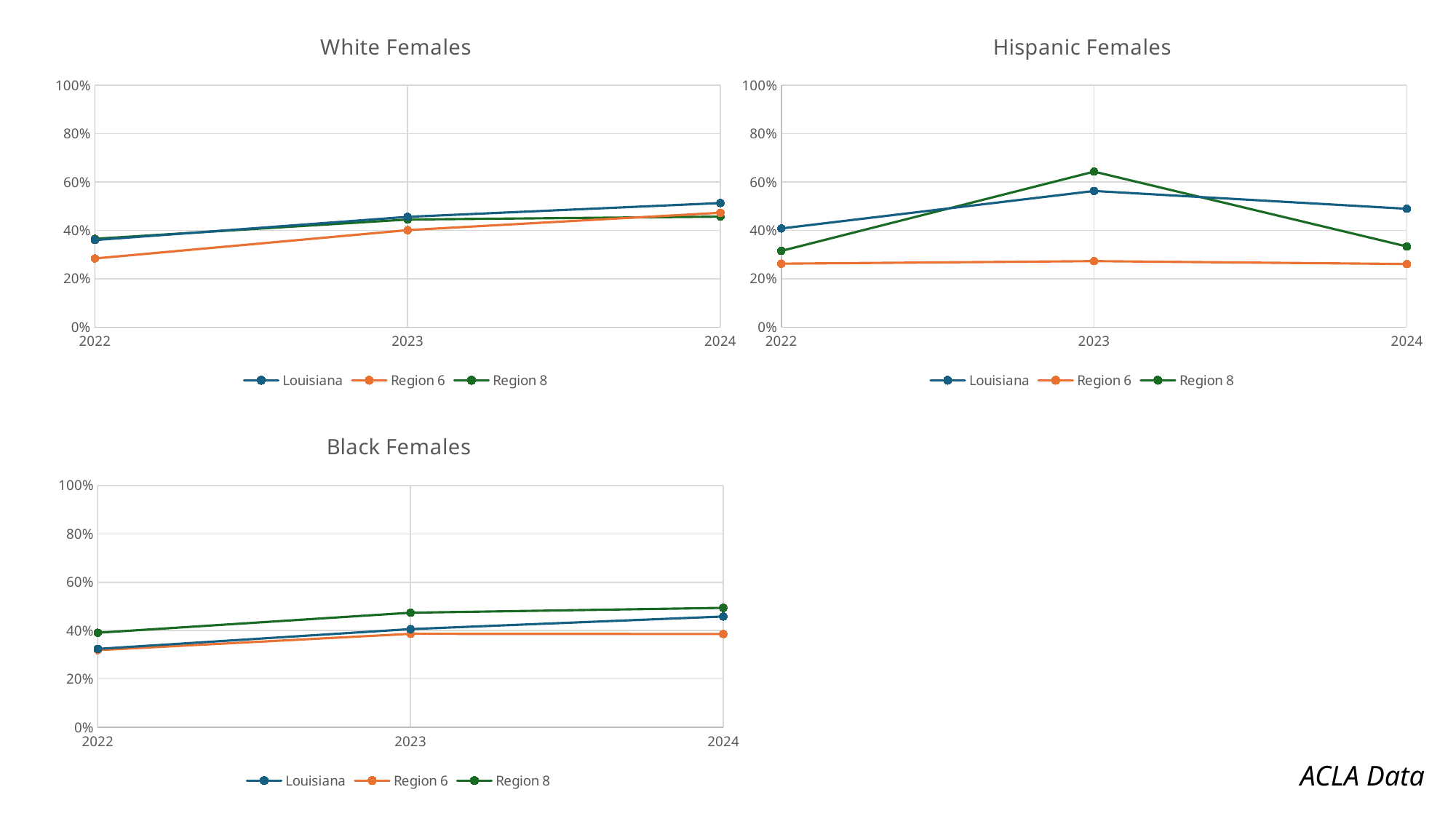
In the "White Females" chart, is the value for Region 6 in 2022 greater or less than 40%? less In the "White Females" chart, does the Region 6 line rise or fall from 2022 to 2024? rise In the "Hispanic Females" chart, which series has the lowest value in 2024? Region 6 How many years are shown on the x axis of the "Black Females" chart? 3 What kind of chart is the "White Females" chart? line chart In the "Hispanic Females" chart, is the value for Region 6 in 2023 greater or less than 40%? less In the "Black Females" chart, is the value for Louisiana in 2024 greater or less than 40%? greater In the "Black Females" chart, which series has the highest value in 2022? Region 8 What is the title of the chart in the bottom-left of the slide? Black Females How many series does the legend of the "Hispanic Females" chart list? 3 In the "Hispanic Females" chart, which series has the highest value in 2023? Region 8